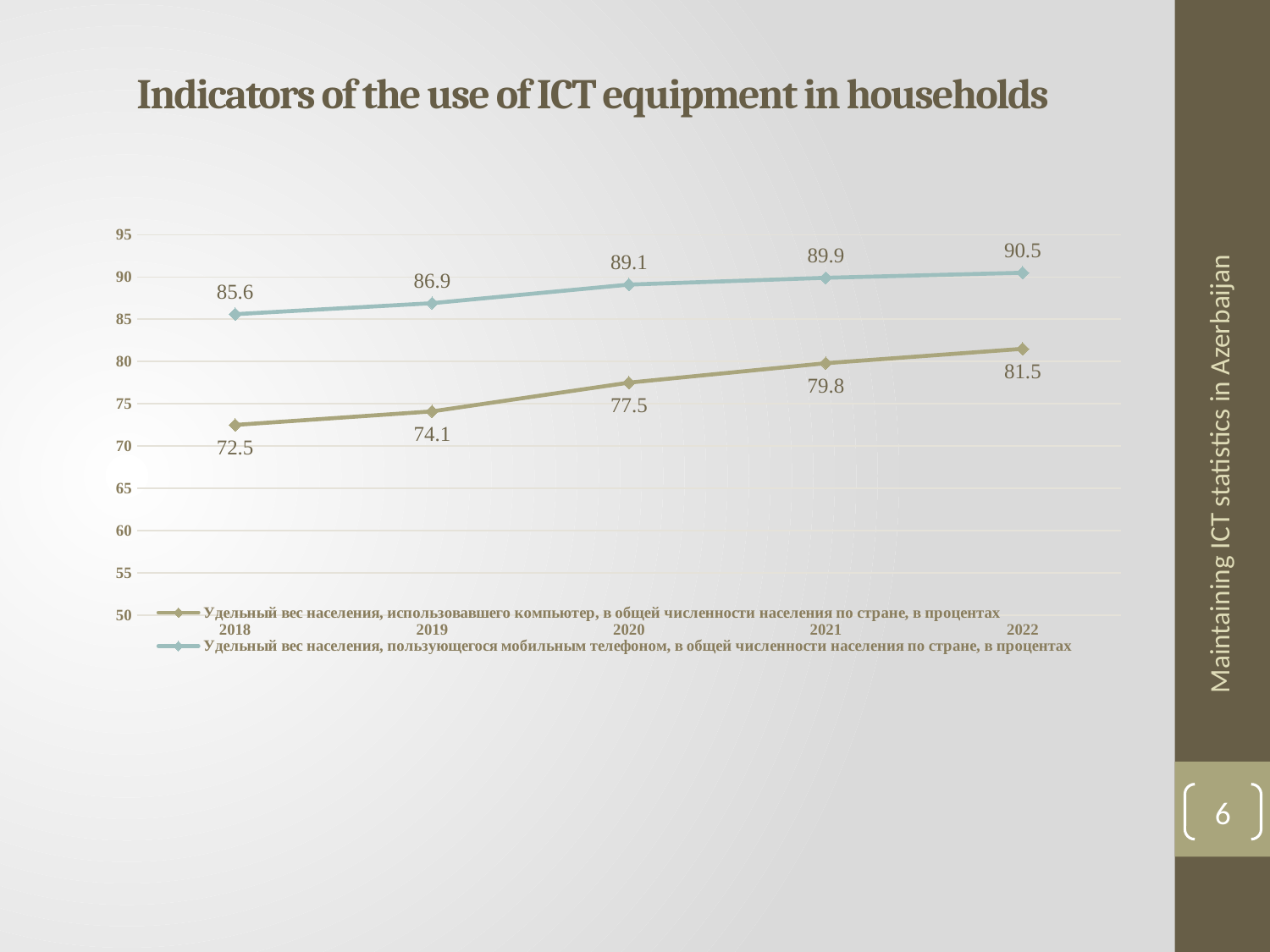
In which year is the computer-use series (the lower line) at its highest? 2022 By how much did the computer-use series (the lower line) increase from 2018 to 2022? 9 Which is larger in 2019: the mobile-phone series value or the computer-use series value? the mobile-phone series (86.9) What is the value for 2022 in the mobile-phone series (the upper line, 'Удельный вес населения, пользующегося мобильным телефоном')? 90.5 How many years are shown on the x axis of the chart? 5 Do the values of the computer-use series rise or fall from 2018 to 2022? rise What is the value for 2020 in the computer-use series (the lower line)? 77.5 What is the difference between the mobile-phone series and the computer-use series in 2021? 10.1 How many series does the chart's legend list? 2 What is the value for 2018 in the computer-use series (the lower line, 'Удельный вес населения, использовавшего компьютер')? 72.5 In which year is the mobile-phone series (the upper line) at its lowest? 2018 What type of chart is shown on the slide? line chart